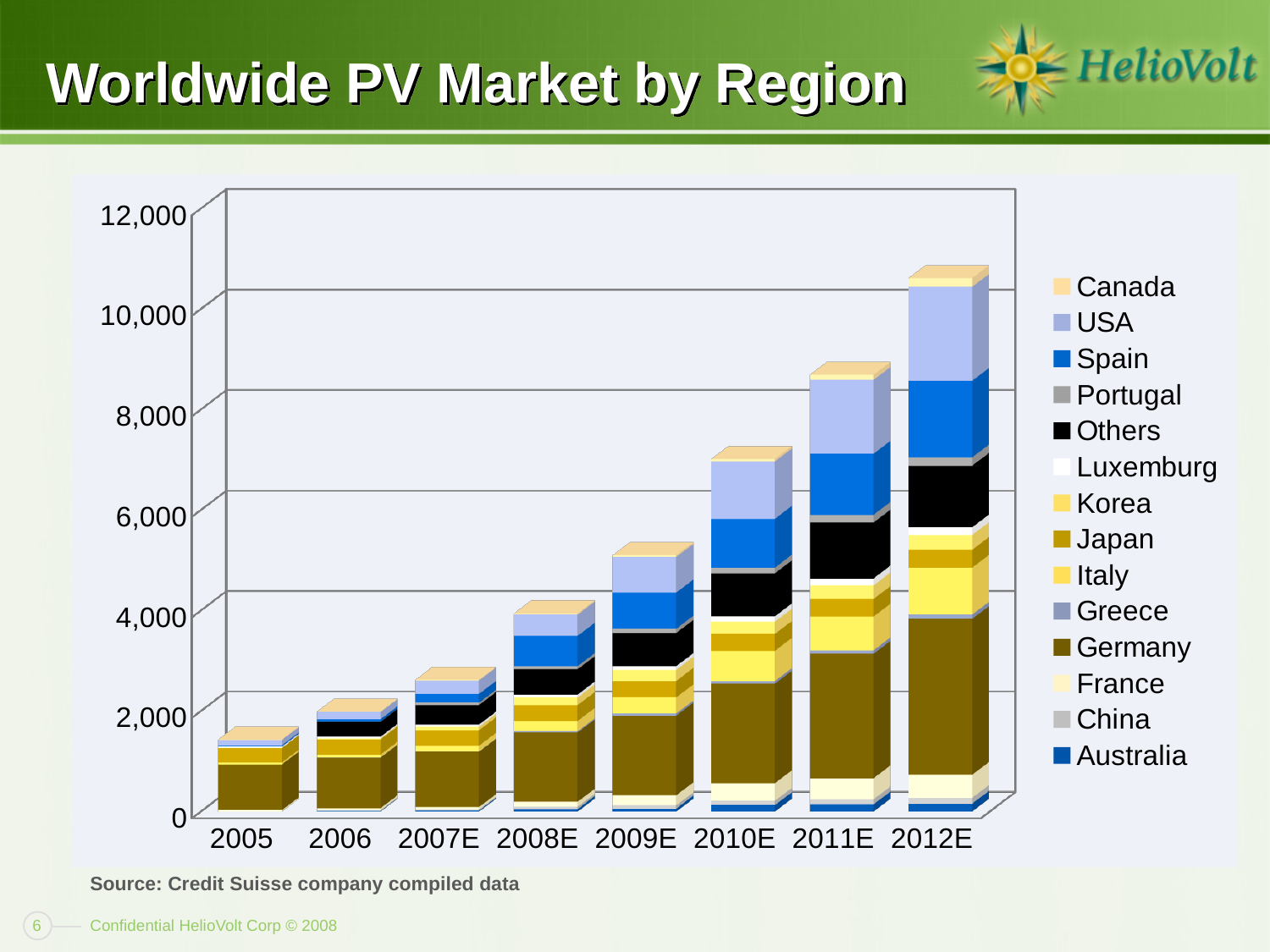
Is the total value for 2010E greater or less than 6,000? greater Which year has a larger total bar, 2009E or 2011E? 2011E Is the total value for 2012E greater or less than 10,000? greater What kind of chart is shown on the slide? stacked bar chart What is the title of the chart on the slide? Worldwide PV Market by Region Which year has the tallest stacked bar in the chart? 2012E Is the total value for 2005 greater or less than 2,000? less Do the total bar heights rise or fall from 2005 to 2012E? rise How many series does the chart's legend list? 14 Which year has the shortest stacked bar in the chart? 2005 How many years (categories) are shown on the x axis of the chart? 8